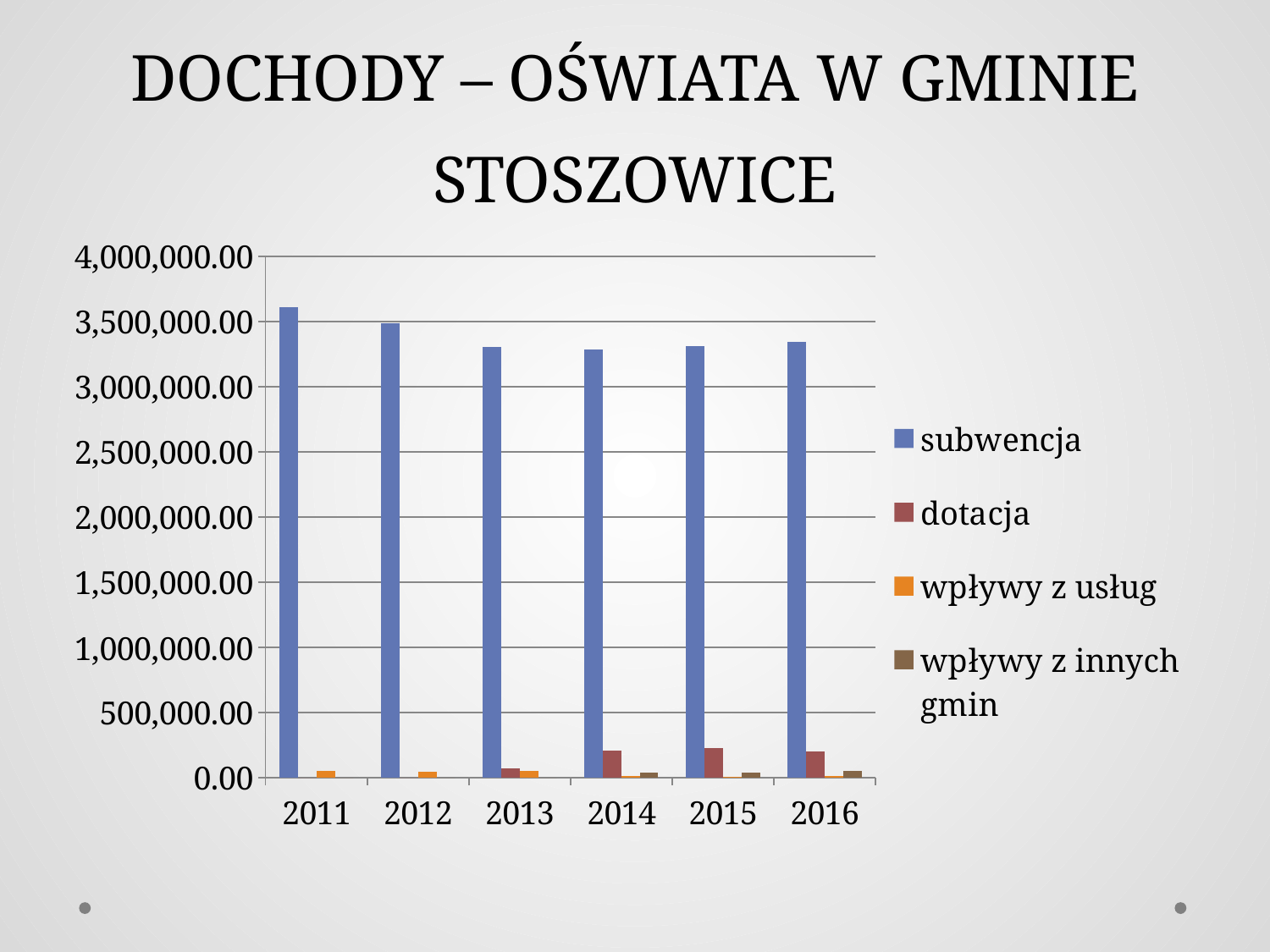
Which is larger, the subwencja value for 2011 or for 2012? 2011 How many years are shown on the x axis of the chart? 6 What is the last entry listed in the chart's legend? wpływy z innych gmin How many series does the chart's legend list? 4 What kind of chart is shown on the slide? bar chart Is the dotacja value for 2015 greater or less than 500,000.00? less Which series is shown in blue in the chart? subwencja Which is larger, the dotacja value for 2013 or for 2014? 2014 Is the subwencja value for 2011 greater or less than 3,500,000.00? greater Does the subwencja value rise or fall from 2011 to 2013? fall Is the subwencja value for 2013 greater or less than 3,500,000.00? less In which year is the subwencja value highest? 2011